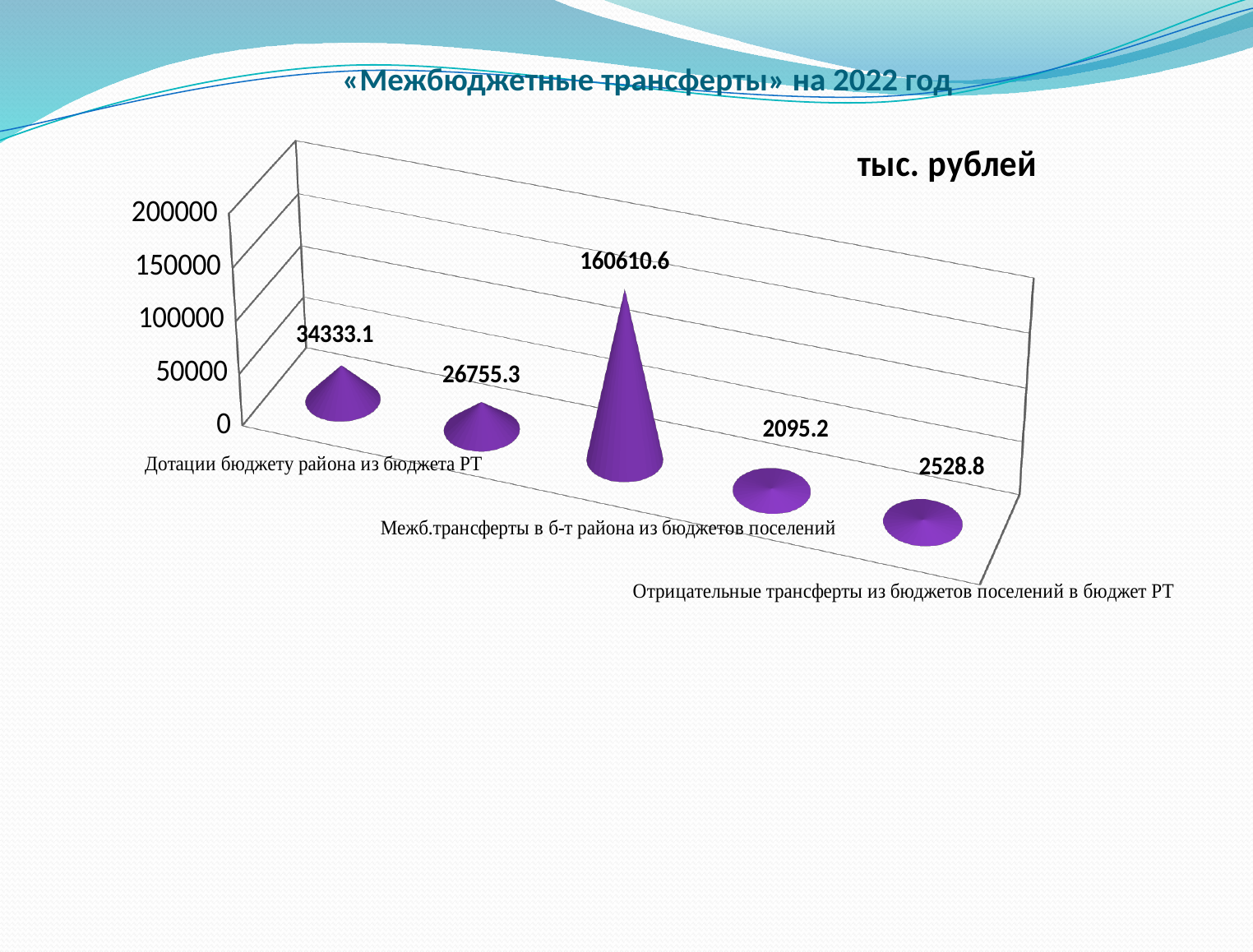
What kind of chart is shown on the slide? bar chart How many data points are plotted on the chart? 5 What is the value for «Дотации бюджету района из бюджета РТ»? 34333.1 What is the smallest value shown on the chart? 2095.2 Is the value for «Межб.трансферты в б-т района из бюджетов поселений» greater or less than 150000? greater In what units are the values on the chart expressed? тыс. рублей What is the value for «Отрицательные трансферты из бюджетов поселений в бюджет РТ»? 2528.8 Is the value for «Дотации бюджету района из бюджета РТ» greater or less than 50000? less Which is larger: the value for «Дотации бюджету района из бюджета РТ» or the value for «Отрицательные трансферты из бюджетов поселений в бюджет РТ»? Дотации бюджету района из бюджета РТ Which category has the highest value? Межб.трансферты в б-т района из бюджетов поселений What is the value for «Межб.трансферты в б-т района из бюджетов поселений»? 160610.6 What is the difference between the value for «Межб.трансферты в б-т района из бюджетов поселений» and the value for «Дотации бюджету района из бюджета РТ»? 126277.5